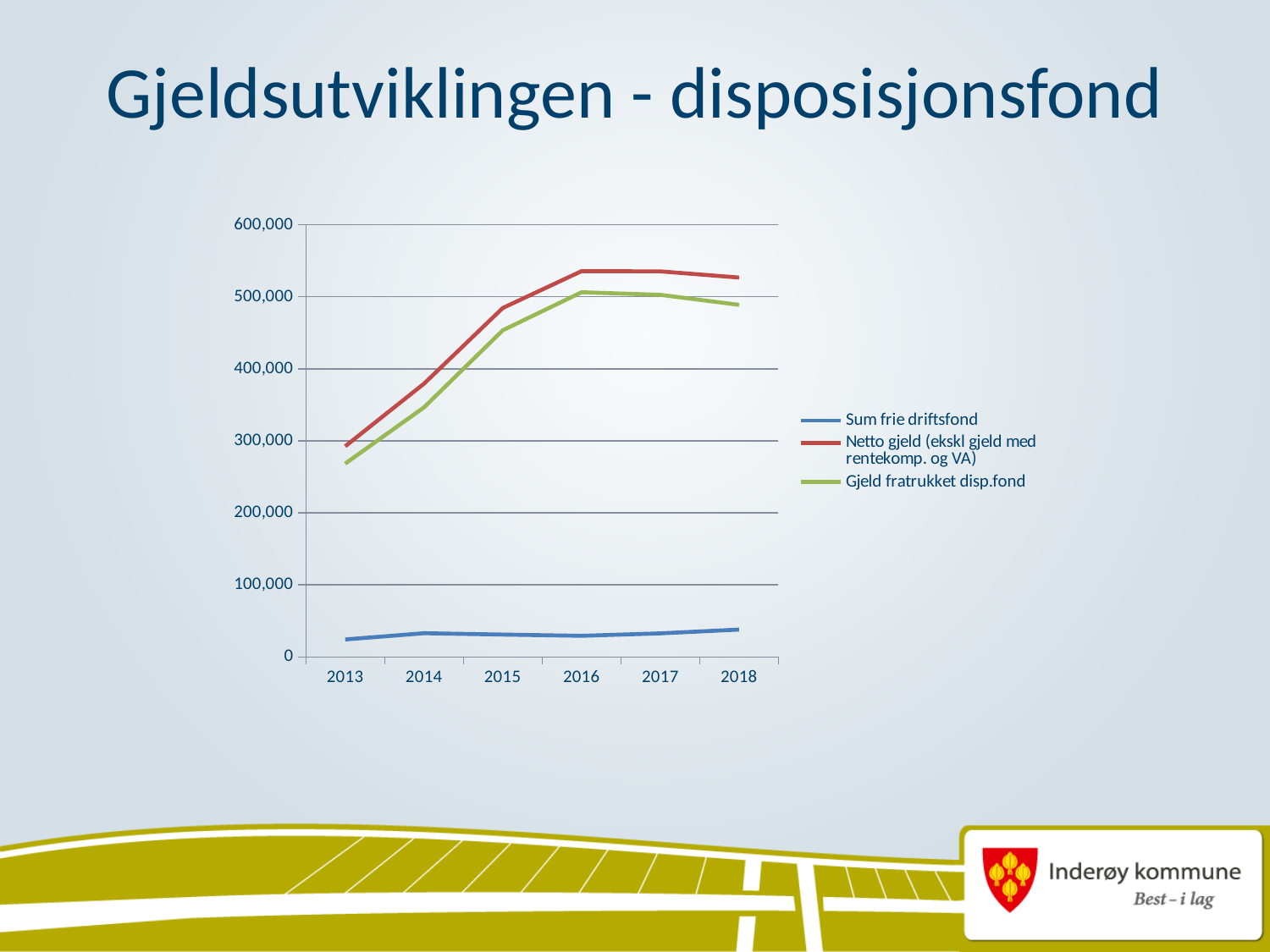
How many series does the legend list? 3 In which year is Sum frie driftsfond highest? 2018 Which series has the highest value in 2016? Netto gjeld (ekskl gjeld med rentekomp. og VA) How many years are shown on the x axis? 6 Is the value for Gjeld fratrukket disp.fond in 2013 greater or less than 300,000? less What is the title of the slide? Gjeldsutviklingen - disposisjonsfond What kind of chart is shown on the slide? line chart In which year is Netto gjeld (ekskl gjeld med rentekomp. og VA) lowest? 2013 Does Gjeld fratrukket disp.fond rise or fall from 2013 to 2016? rise Is the value for Sum frie driftsfond in 2018 greater or less than 100,000? less Is the value for Netto gjeld (ekskl gjeld med rentekomp. og VA) in 2014 greater or less than 400,000? less